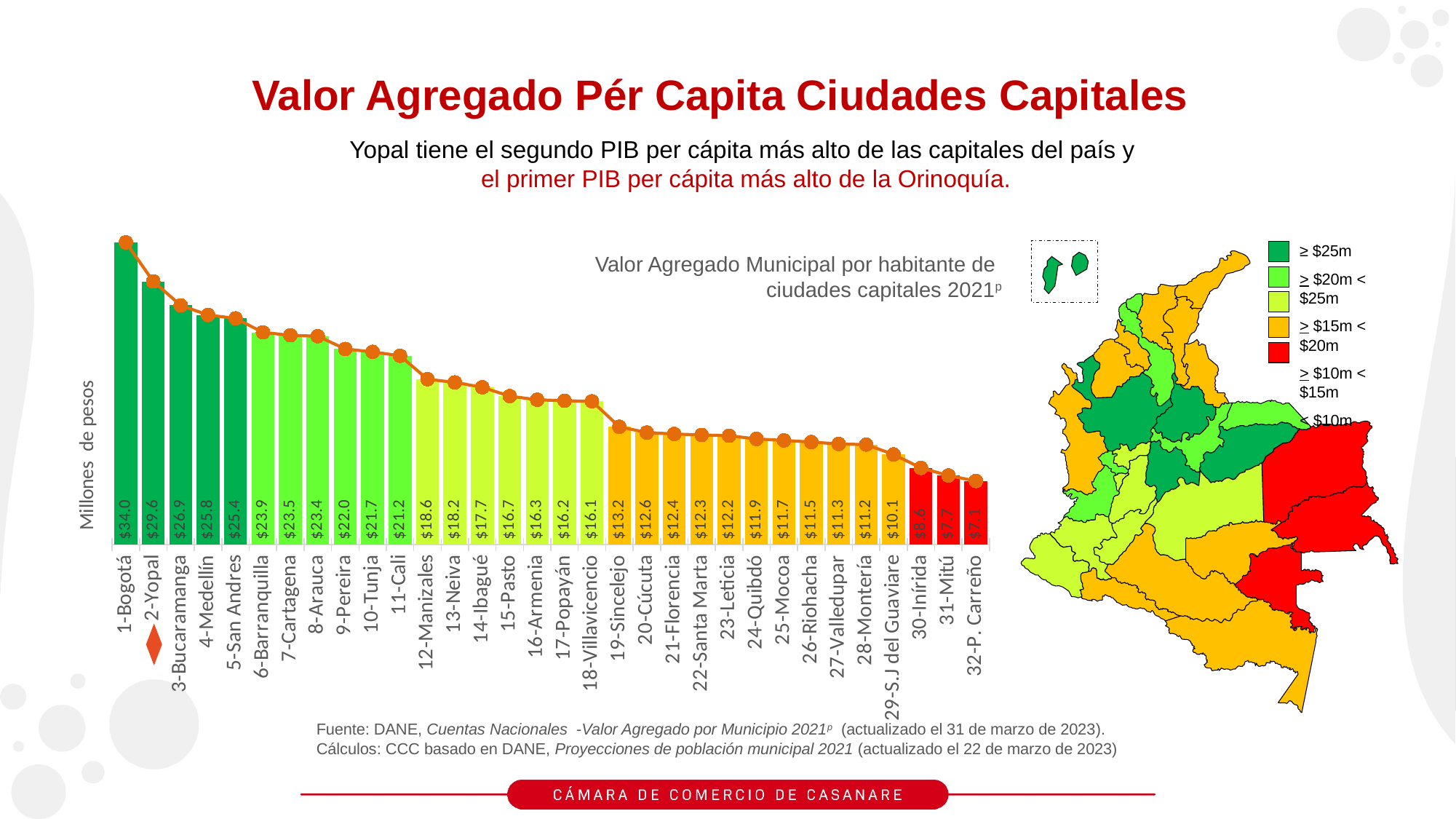
Which has a larger value in the bar chart, 6-Barranquilla or 9-Pereira? 6-Barranquilla What is the value shown for 2-Yopal in the bar chart? $29.6 What is the value shown for 18-Villavicencio in the bar chart? $16.1 What is the difference between the values for 11-Cali and 12-Manizales in the bar chart? $2.6 Which city has the highest value in the bar chart? 1-Bogotá What is the value shown for 8-Arauca in the bar chart? $23.4 How many cities are shown in the bar chart? 32 What is the difference between the values for 1-Bogotá and 2-Yopal in the bar chart? $4.4 Which city has the lowest value in the bar chart? 32-P. Carreño What is the title of the bar chart? Valor Agregado Municipal por habitante de ciudades capitales 2021ᵖ What is the value shown for 29-S.J del Guaviare in the bar chart? $10.1 Do the values in the bar chart rise or fall from left to right? fall